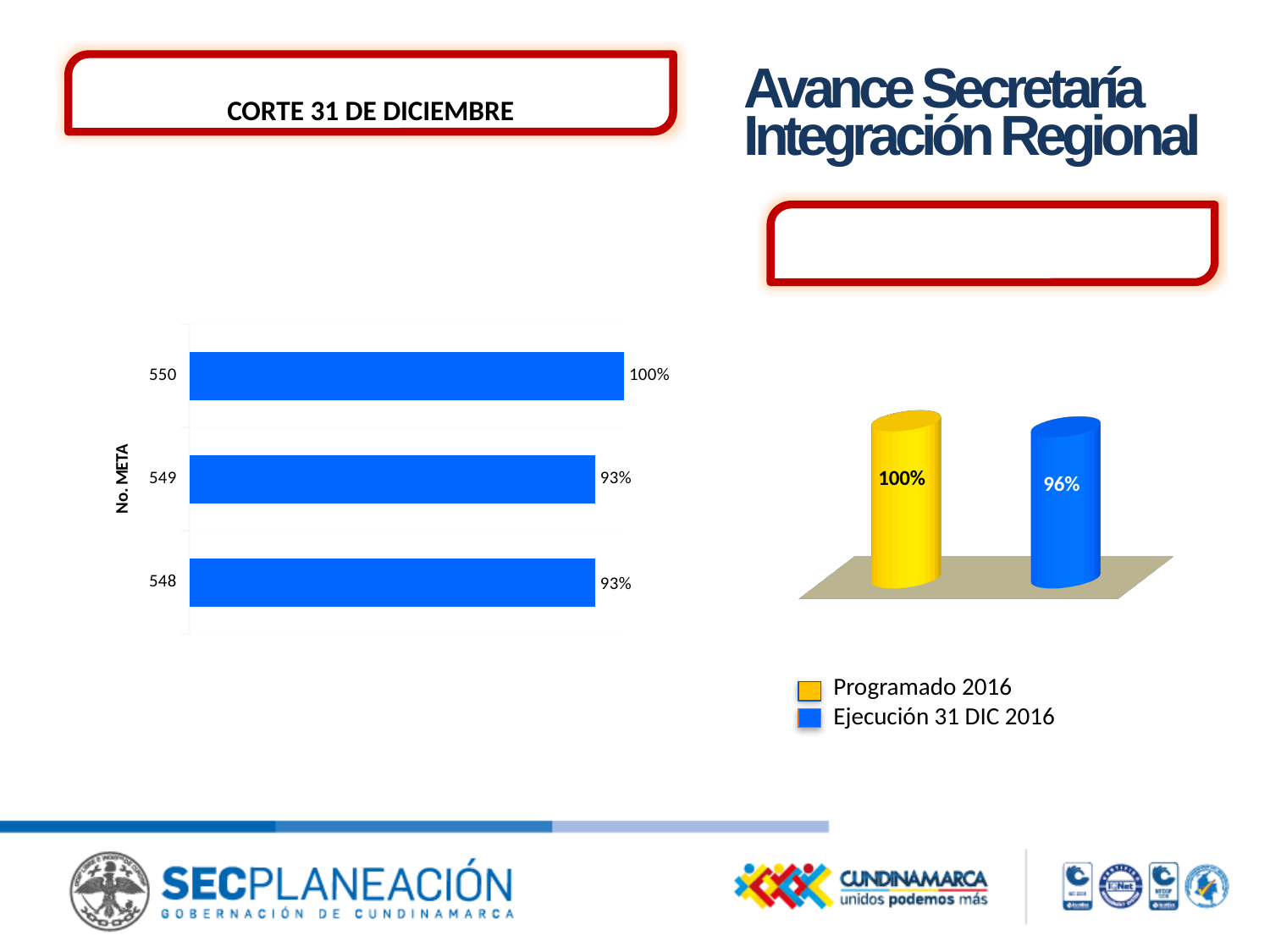
In the chart on the right, what is the value for Ejecución 31 DIC 2016? 96% In the bar chart on the left, what is the value for meta 548? 93% In the bar chart on the left, what is the value for meta 550? 100% In the bar chart on the left, what is the difference between the values for meta 550 and meta 548? 7% In the chart on the right, what is the difference between Programado 2016 and Ejecución 31 DIC 2016? 4% In the bar chart on the left, how many metas are plotted? 3 In the bar chart on the left, what is the label of the vertical axis? No. META What kind of chart is the chart on the left? bar chart In the bar chart on the left, what is the value for meta 549? 93% In the bar chart on the left, which meta has the highest value? 550 In the chart on the right, what is the value for Programado 2016? 100% In the chart on the right, how many entries does the legend list? 2